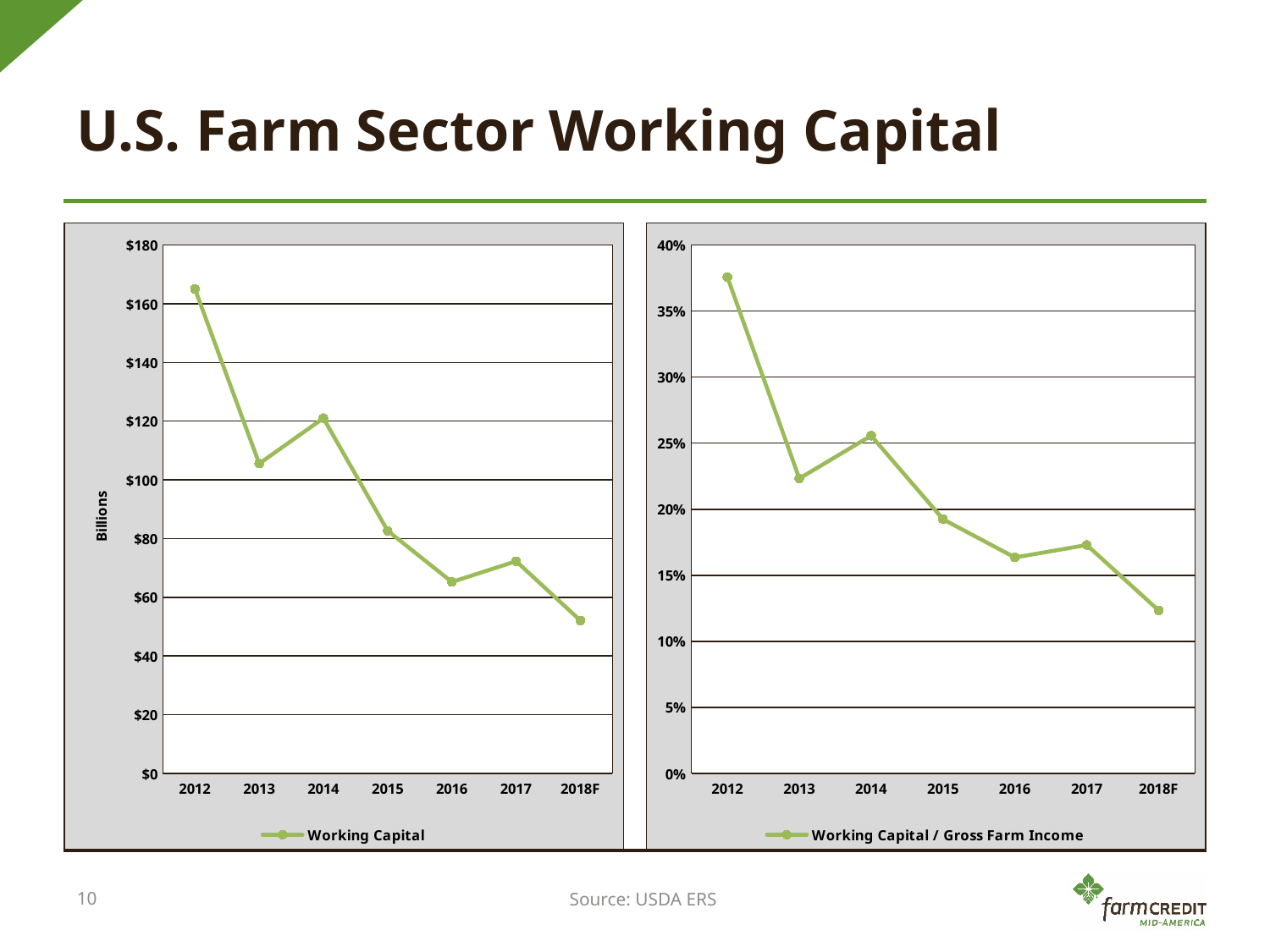
What kind of chart is the left chart on the slide? line chart In the left chart (Working Capital), which is larger, the value for 2013 or the value for 2014? 2014 In the right chart (Working Capital / Gross Farm Income), which year has the highest value? 2012 In the left chart (Working Capital), which year has the highest value? 2012 In the left chart (Working Capital), is the value for 2016 greater or less than $80? less In the left chart (Working Capital), which year has the lowest value? 2018F In the right chart (Working Capital / Gross Farm Income), is the value for 2018F greater or less than 15%? less How many years are plotted on the x axis of the left chart? 7 What is the legend entry of the right chart? Working Capital / Gross Farm Income In the left chart (Working Capital), is the value for 2012 greater or less than $160? greater In the right chart (Working Capital / Gross Farm Income), what is the overall trend from 2012 to 2018F? falling